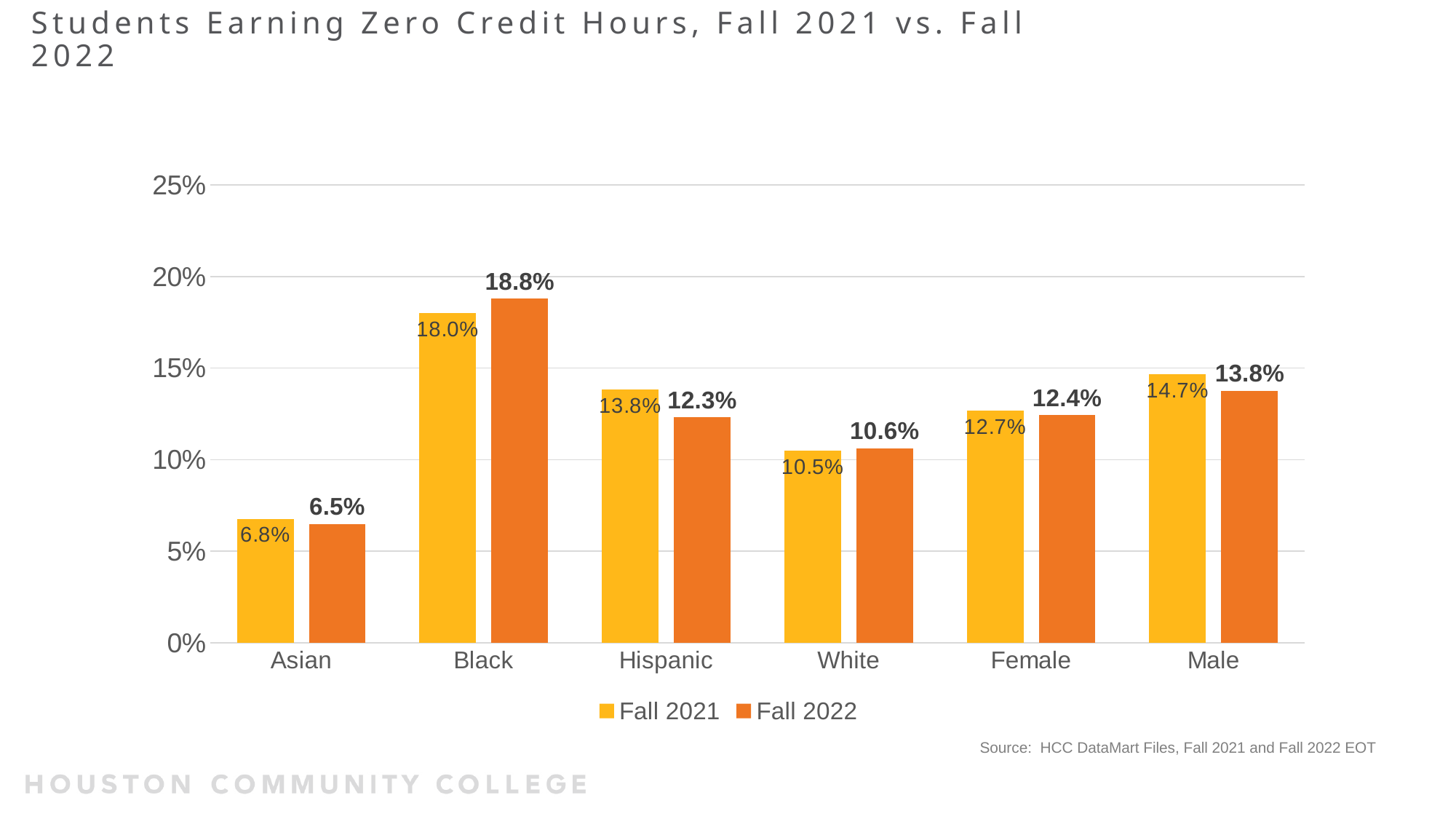
How many series does the legend list? 2 How many categories are shown on the x axis? 6 Which is larger for Female students, the Fall 2021 value or the Fall 2022 value? Fall 2021 Which category has the lowest Fall 2022 value? Asian Which category has the highest Fall 2021 value? Black What is the Fall 2021 value for Asian students? 6.8% What is the Fall 2022 value for Male students? 13.8% What kind of chart is shown on the slide? bar chart Is the Fall 2021 value for White students greater or less than 15%? less What is the title of the chart? Students Earning Zero Credit Hours, Fall 2021 vs. Fall 2022 What is the Fall 2022 value for Black students? 18.8% What is the difference between the Fall 2022 and Fall 2021 values for Hispanic students? 1.5%